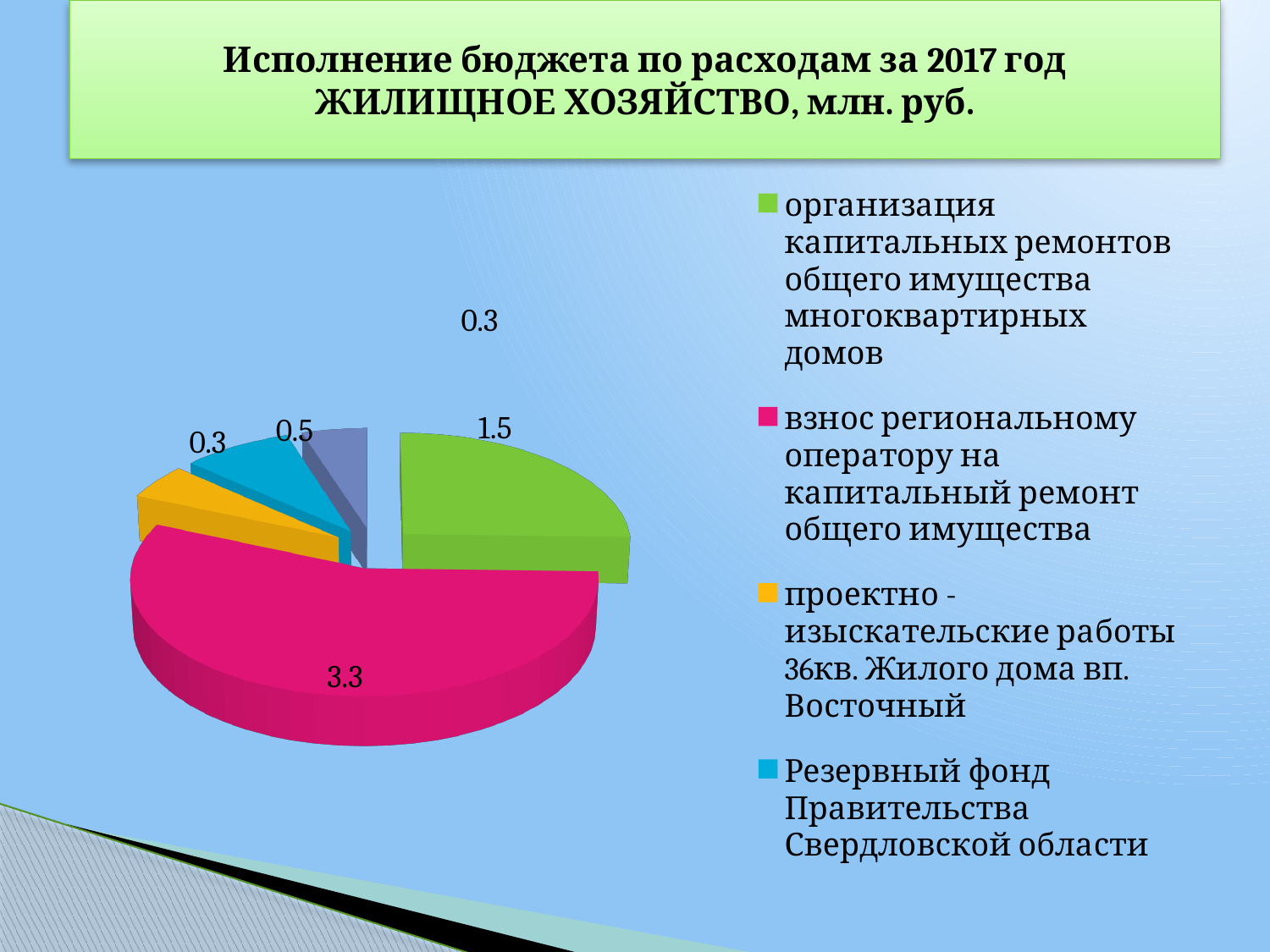
What colour is the slice for "взнос региональному оператору на капитальный ремонт общего имущества"? pink What is the difference between the values for "Резервный фонд Правительства Свердловской области" and "проектно - изыскательские работы 36кв. Жилого дома вп. Восточный"? 0.2 What is the value for "проектно - изыскательские работы 36кв. Жилого дома вп. Восточный"? 0.3 What is the value for "взнос региональному оператору на капитальный ремонт общего имущества"? 3.3 What is the difference between the values for "взнос региональному оператору на капитальный ремонт общего имущества" and "организация капитальных ремонтов общего имущества многоквартирных домов"? 1.8 What is the title of the slide containing the chart? Исполнение бюджета по расходам за 2017 год ЖИЛИЩНОЕ ХОЗЯЙСТВО, млн. руб. What is the value for "Резервный фонд Правительства Свердловской области"? 0.5 Which category has the largest slice of the pie? взнос региональному оператору на капитальный ремонт общего имущества Which is larger: the value for "организация капитальных ремонтов общего имущества многоквартирных домов" or the value for "Резервный фонд Правительства Свердловской области"? организация капитальных ремонтов общего имущества многоквартирных домов How many slices does the pie chart have? 5 What kind of chart is shown on the slide? pie chart What is the value for "организация капитальных ремонтов общего имущества многоквартирных домов"? 1.5